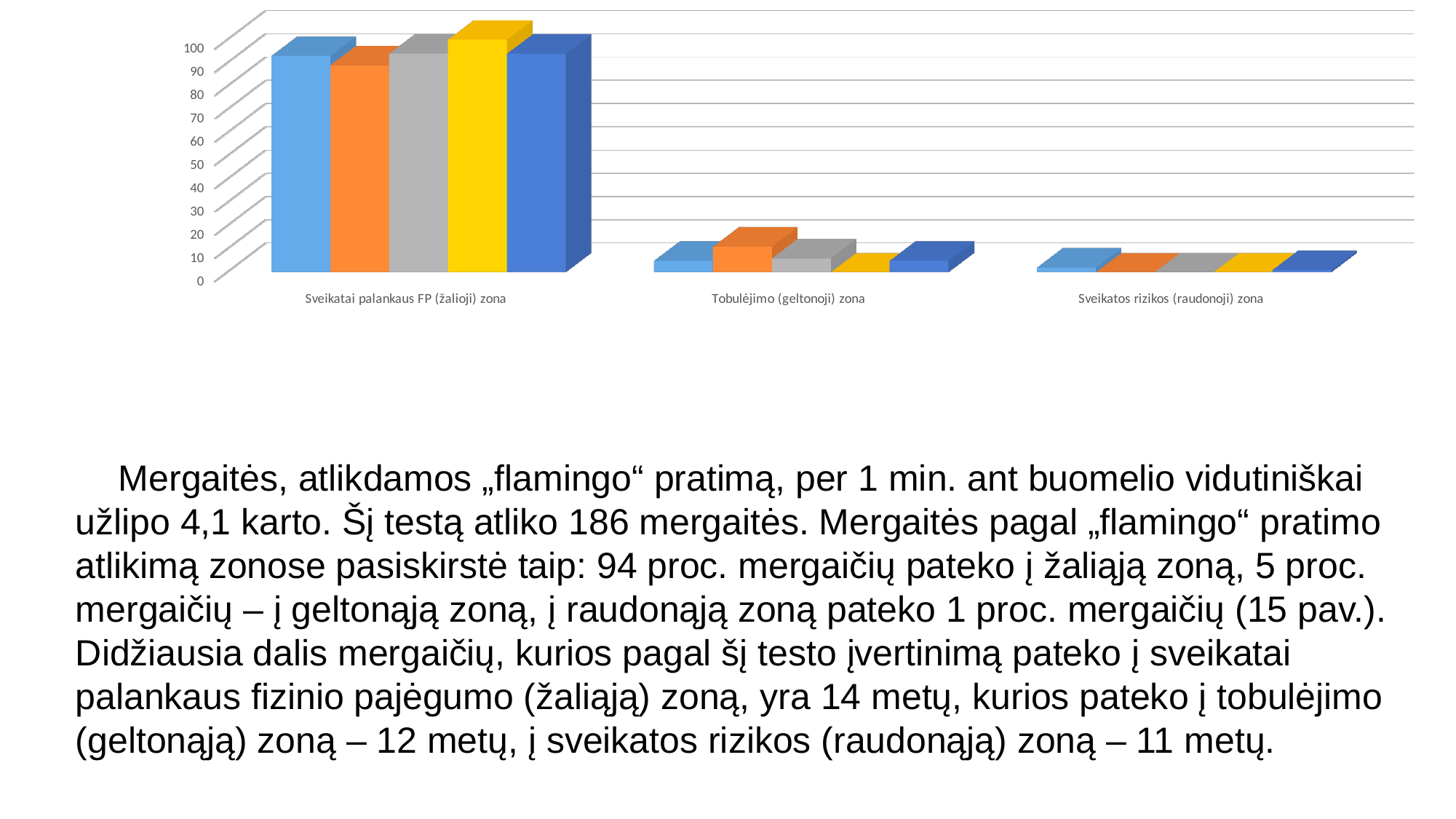
How many categories are shown on the x axis of the chart? 3 Are the bars for Sveikatai palankaus FP (žalioji) zona greater or less than 80? greater What is the highest value shown on the vertical axis of the chart? 100 How many bars are drawn for each category in the chart? 5 Which category has larger values: Sveikatai palankaus FP (žalioji) zona or Tobulėjimo (geltonoji) zona? Sveikatai palankaus FP (žalioji) zona Which category has larger values: Tobulėjimo (geltonoji) zona or Sveikatos rizikos (raudonoji) zona? Tobulėjimo (geltonoji) zona Are the bars for Sveikatos rizikos (raudonoji) zona greater or less than 10? less Which category has the highest bars in the chart? Sveikatai palankaus FP (žalioji) zona Which category has the lowest bars in the chart? Sveikatos rizikos (raudonoji) zona Do the values rise or fall moving from left to right along the x axis? fall What kind of chart is shown on the slide? bar chart Are the bars for Tobulėjimo (geltonoji) zona greater or less than 20? less